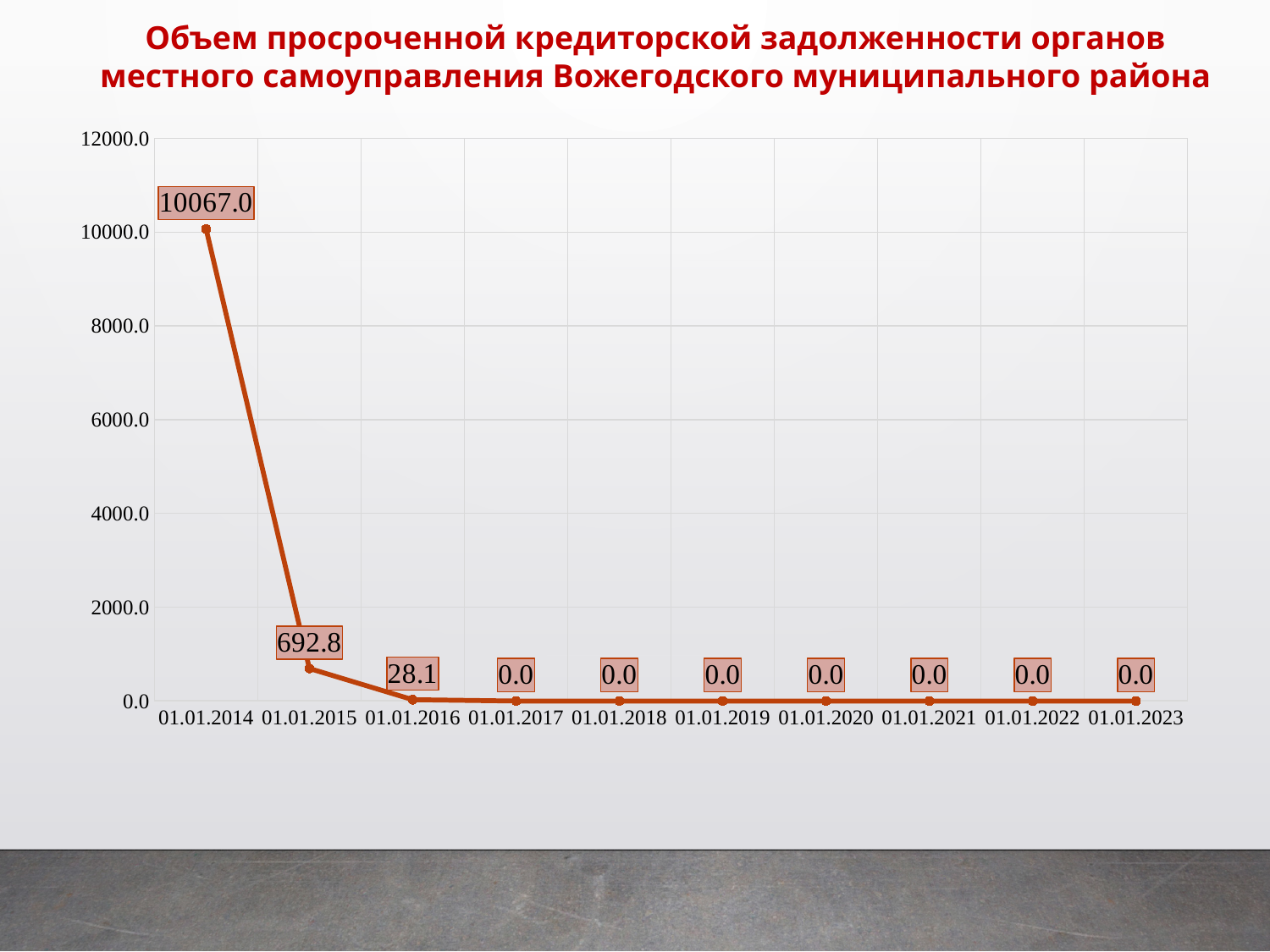
What is the value for 01.01.2014? 10067.0 Which date has the highest value? 01.01.2014 Do the values rise or fall from 01.01.2014 to 01.01.2016? fall What is the value for 01.01.2016? 28.1 What is the difference between the values for 01.01.2014 and 01.01.2015? 9374.2 What is the value for 01.01.2020? 0.0 Is the value for 01.01.2014 greater or less than 8000.0? greater How many data points are plotted on the chart? 10 What kind of chart is shown on the slide? line chart What is the value for 01.01.2015? 692.8 Which is larger, the value for 01.01.2015 or the value for 01.01.2016? 01.01.2015 What is the difference between the values for 01.01.2015 and 01.01.2016? 664.7